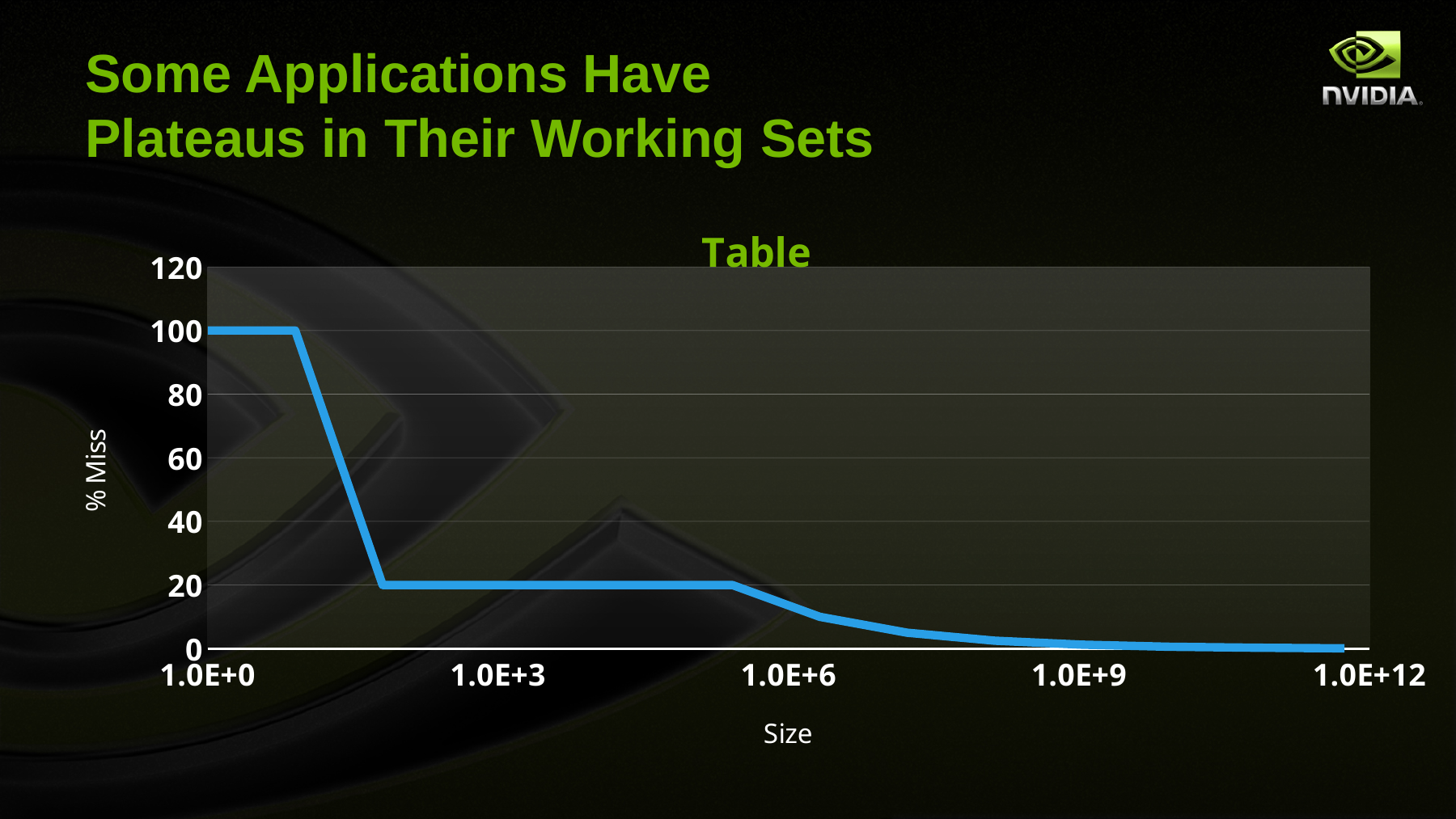
What is the difference in % Miss between Size 1.0E+0 and Size 1.0E+3? 80 What is the % Miss value at Size 1.0E+0? 100 Which Size has the higher % Miss, 1.0E+0 or 1.0E+3? 1.0E+0 What is the % Miss value at Size 1.0E+3? 20 Does the % Miss rise or fall as Size increases along the x axis? fall Is the % Miss value at Size 1.0E+9 greater or less than 20? less Is the % Miss value at Size 1.0E+6 greater or less than 40? less How many tick labels are shown on the x axis? 5 Is the % Miss value at Size 1.0E+12 greater or less than 20? less What is the label of the y axis? % Miss What kind of chart is shown on the slide? line chart What is the title of the chart? Table